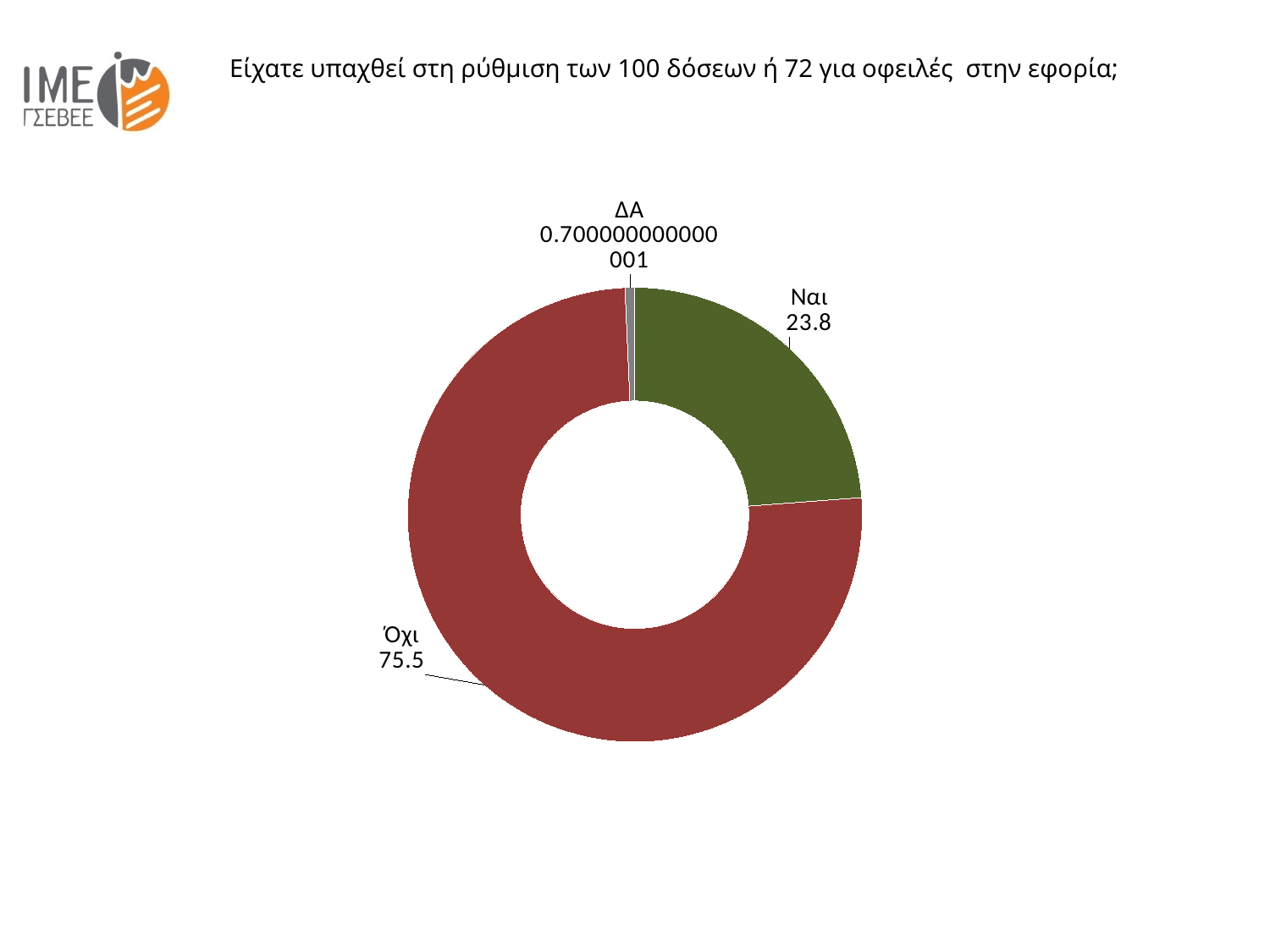
What is the value printed for ΔΑ? 0.700000000000001 What is the value for Όχι? 75.5 What is the difference between the values for Όχι and Ναι? 51.7 Which category has the largest slice? Όχι How many categories (slices) does the chart have? 3 Which is larger, the value for Ναι or the value for Όχι? Όχι What is the title of the chart? Είχατε υπαχθεί στη ρύθμιση των 100 δόσεων ή 72 για οφειλές στην εφορία; Which category has the smallest slice? ΔΑ What colour is the Ναι slice? Green What share of the chart does the Όχι slice represent? 75.5 What type of chart is shown on the slide? Doughnut (pie) chart What is the value for Ναι? 23.8